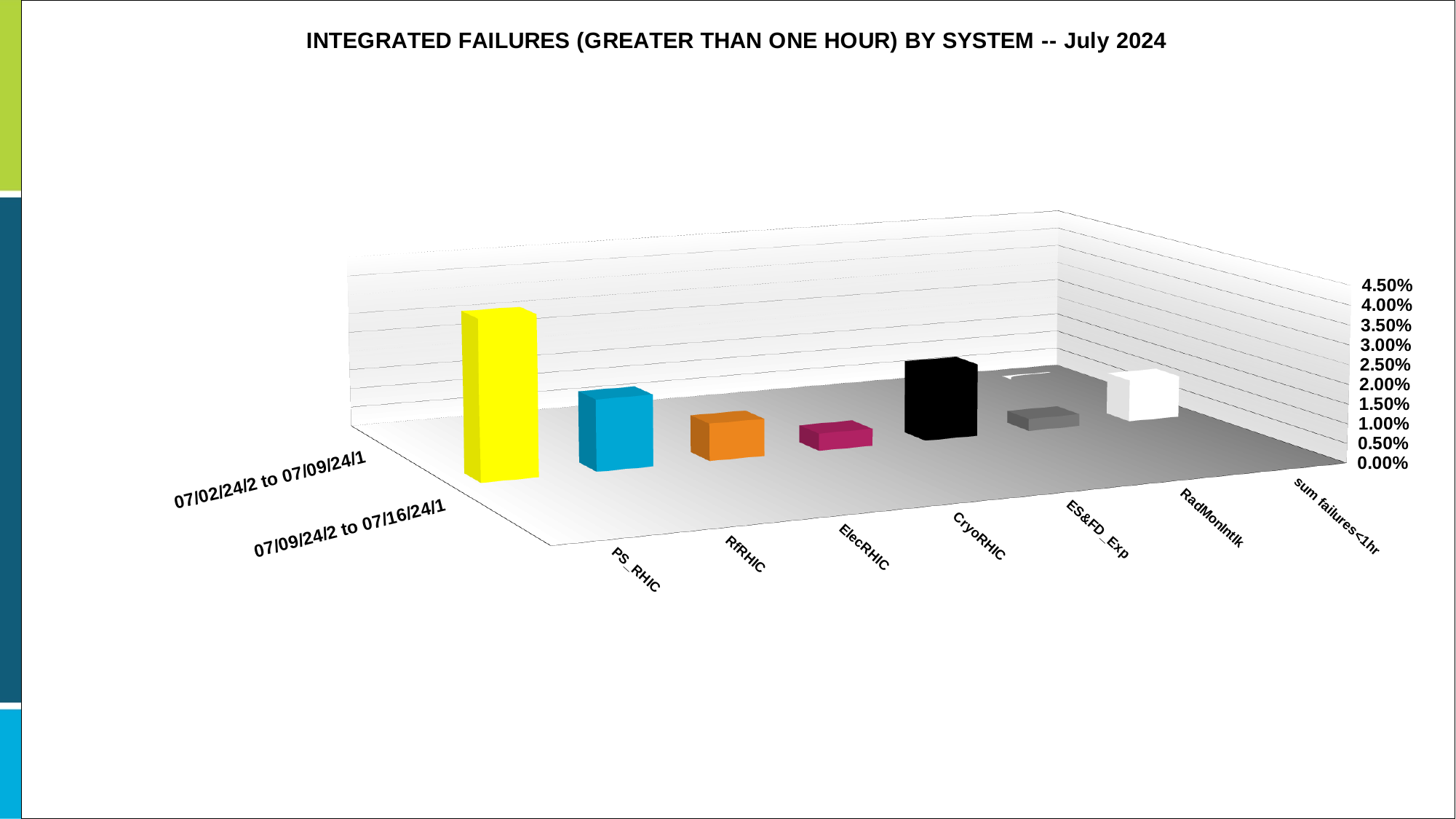
What kind of chart is shown on the slide? bar chart What is the title of the chart? INTEGRATED FAILURES (GREATER THAN ONE HOUR) BY SYSTEM -- July 2024 Which system has the highest bar in the chart? PS_RHIC Which is larger, the value for CryoRHIC or the value for ElecRHIC? ElecRHIC Is the value for ElecRHIC greater or less than 2.50%? less How many date ranges are listed along the depth axis of the chart? 2 What colour is the bar for PS_RHIC? yellow Is the value for PS_RHIC greater or less than 1.00%? greater Which is larger, the value for PS_RHIC or the value for RfRHIC? PS_RHIC How many system categories are shown along the category axis? 7